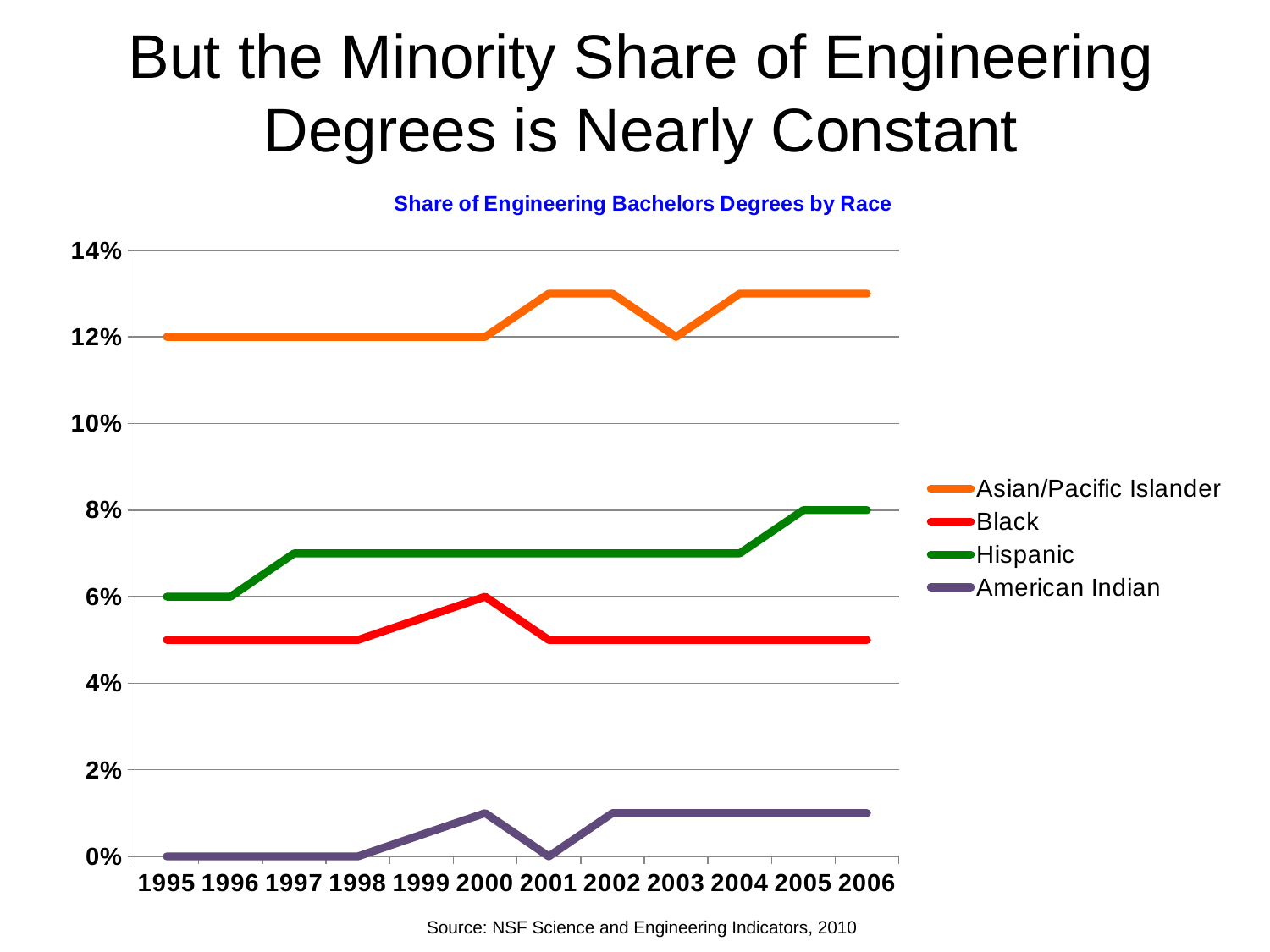
What is the share for Black in 2000? 6% What type of chart is shown on the slide? Line chart How many series does the legend list? 4 Which series has the lowest share across the chart? American Indian Which series has the highest share across the chart? Asian/Pacific Islander What is the share for Hispanic in 2006? 8% Is the value for Asian/Pacific Islander in 2001 greater or less than 12%? greater What is the share for American Indian in 1995? 0% Is the value for Black in 2006 greater or less than 6%? less What is the difference between the Asian/Pacific Islander share and the Hispanic share in 1995? 6% How many years are shown on the x axis? 12 What is the share for Asian/Pacific Islander in 1995? 12%